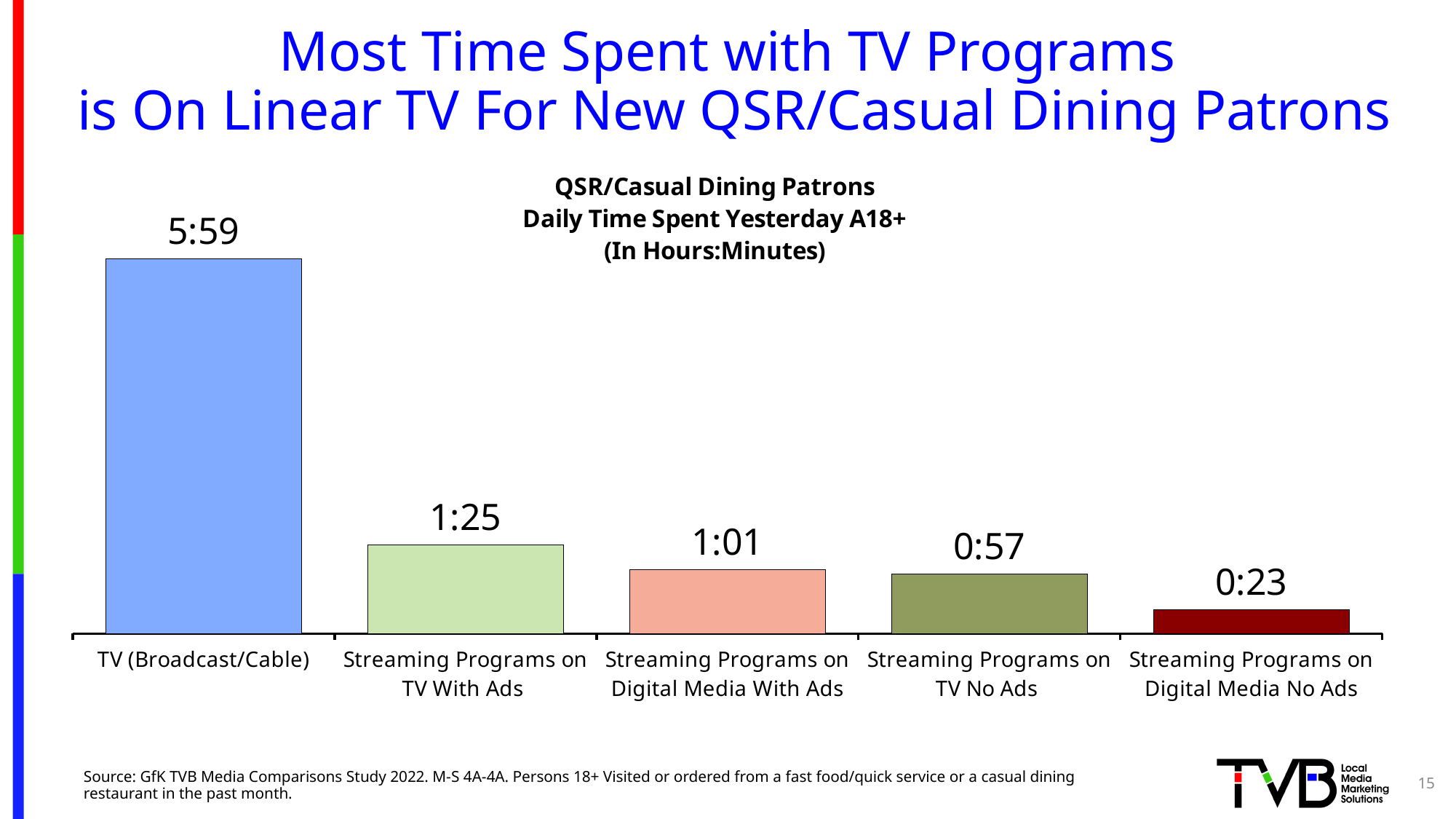
What is the daily time spent for Streaming Programs on Digital Media With Ads? 1:01 In what units are the chart values expressed, according to the chart title? Hours:Minutes Do the values rise or fall moving from left to right across the categories? Fall What is the daily time spent for Streaming Programs on Digital Media No Ads? 0:23 What is the daily time spent for TV (Broadcast/Cable)? 5:59 Which category has the highest daily time spent? TV (Broadcast/Cable) What is the daily time spent for Streaming Programs on TV With Ads? 1:25 Which is larger: the time spent on Streaming Programs on TV With Ads or on Streaming Programs on Digital Media No Ads? Streaming Programs on TV With Ads How many categories are shown in the chart? 5 What is the daily time spent for Streaming Programs on TV No Ads? 0:57 Which category has the lowest daily time spent? Streaming Programs on Digital Media No Ads What kind of chart is shown on the slide? Bar chart